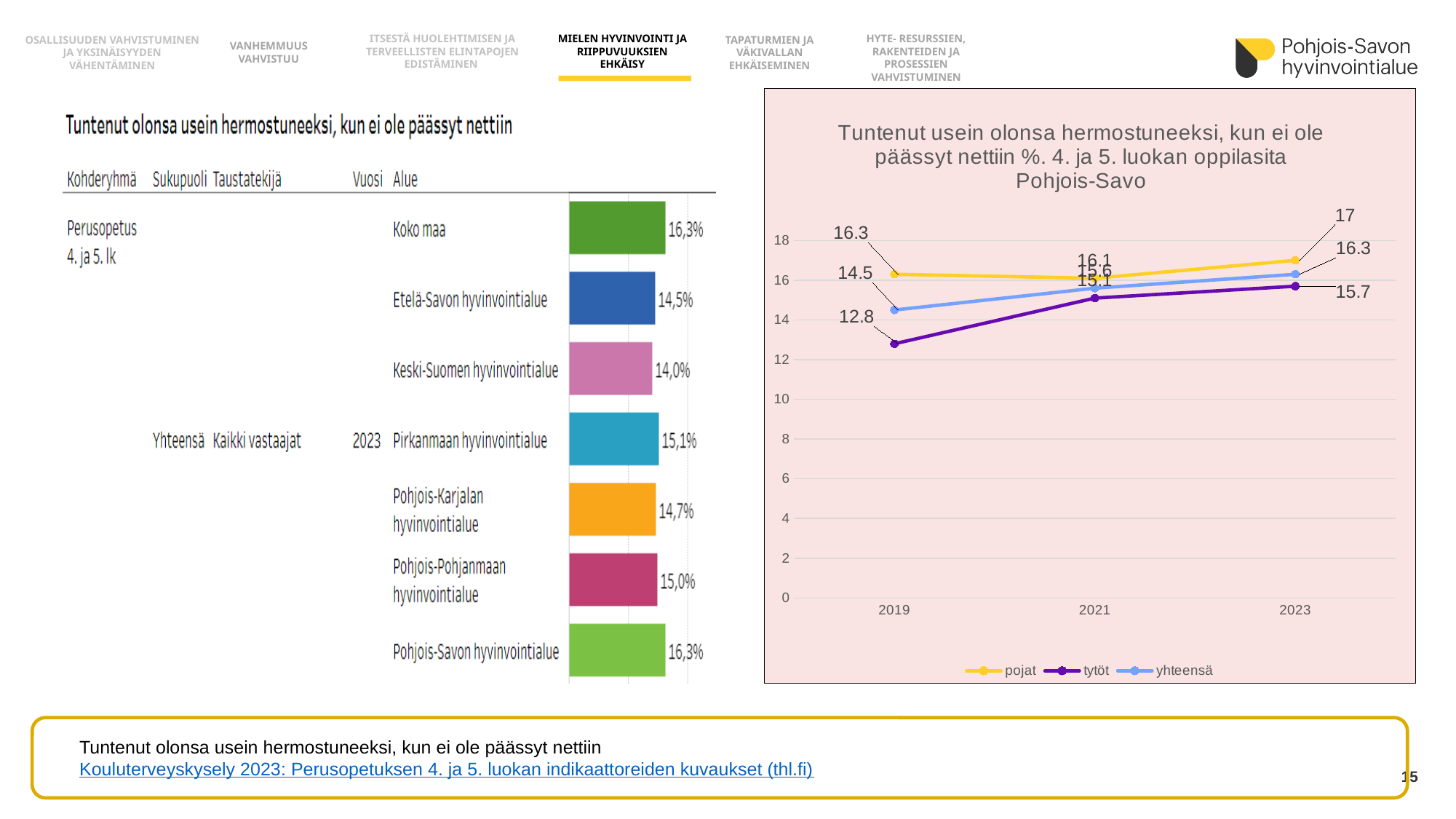
What kind of chart is the chart on the left of the slide? Bar chart In the right line chart (Pohjois-Savo), what is the value for pojat in 2023? 17 In the left bar chart, what is the difference between Pohjois-Savon hyvinvointialue and Etelä-Savon hyvinvointialue? 1,8 percentage points In the right line chart (Pohjois-Savo), does the tytöt series rise or fall from 2019 to 2023? Rise In the right line chart (Pohjois-Savo), what is the difference between pojat and tytöt in 2021? 1 In the left bar chart, which region has the lowest value? Keski-Suomen hyvinvointialue In the right line chart (Pohjois-Savo), what is the value for tytöt in 2019? 12.8 In the left bar chart, what is the value for Keski-Suomen hyvinvointialue? 14,0% In the left bar chart, which is larger: Pohjois-Karjalan hyvinvointialue or Pohjois-Pohjanmaan hyvinvointialue? Pohjois-Pohjanmaan hyvinvointialue In the right line chart (Pohjois-Savo), how many series does the legend list? 3 In the left bar chart, what is the value for Pirkanmaan hyvinvointialue? 15,1% How many bars are shown in the left bar chart? 7